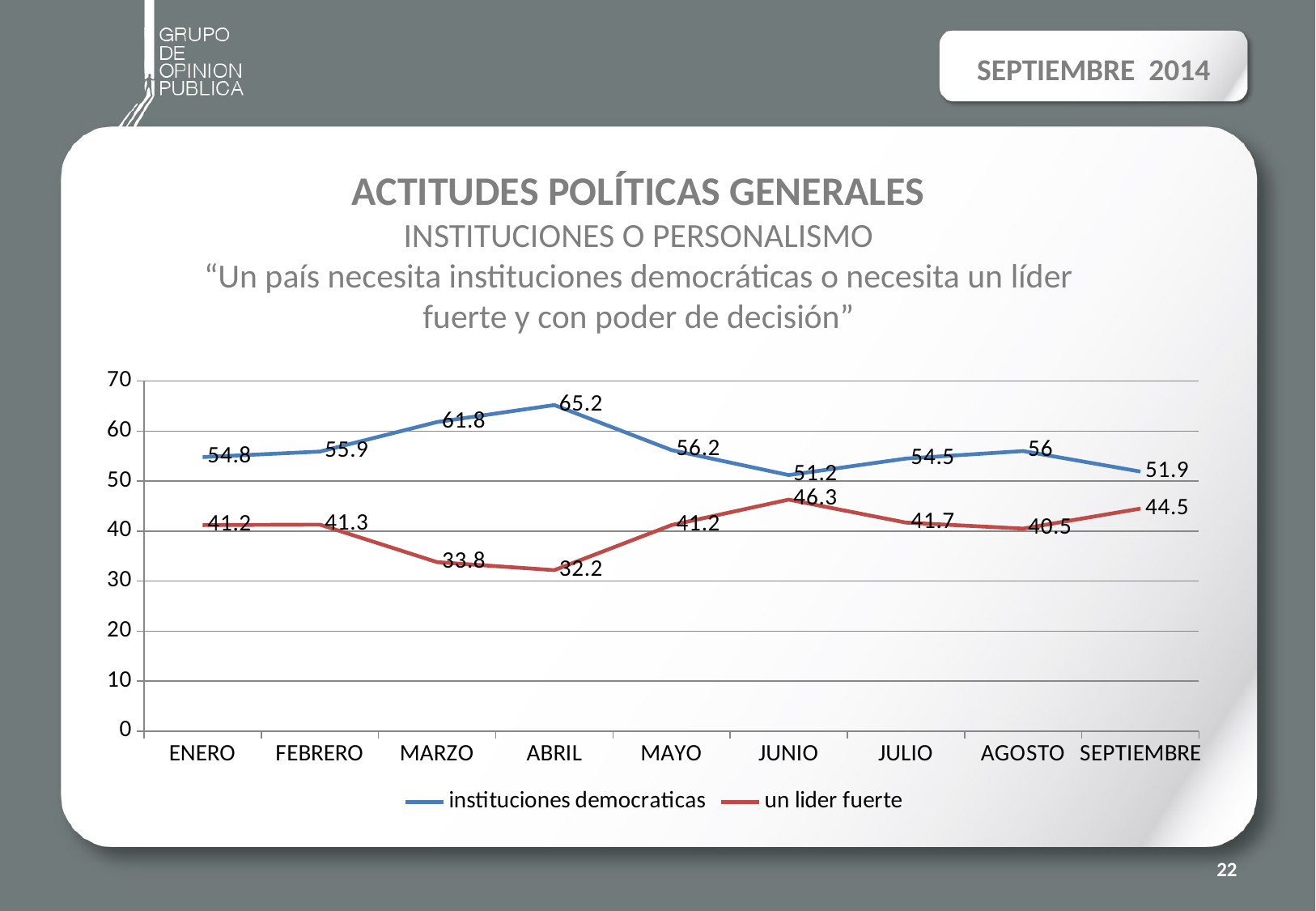
In which month does 'un lider fuerte' reach its lowest value? ABRIL What is the value for 'instituciones democraticas' in ABRIL? 65.2 In which month does 'instituciones democraticas' reach its lowest value? JUNIO In which month does 'instituciones democraticas' reach its highest value? ABRIL What is the value for 'un lider fuerte' in SEPTIEMBRE? 44.5 What is the value for 'un lider fuerte' in MARZO? 33.8 What kind of chart is shown on the slide? line chart How many months are shown on the x axis? 9 Which series has the larger value in JUNIO, 'instituciones democraticas' or 'un lider fuerte'? instituciones democraticas What is the difference between 'instituciones democraticas' and 'un lider fuerte' in ABRIL? 33 Does the value for 'un lider fuerte' rise or fall from ABRIL to JUNIO? rise How many series does the legend list? 2